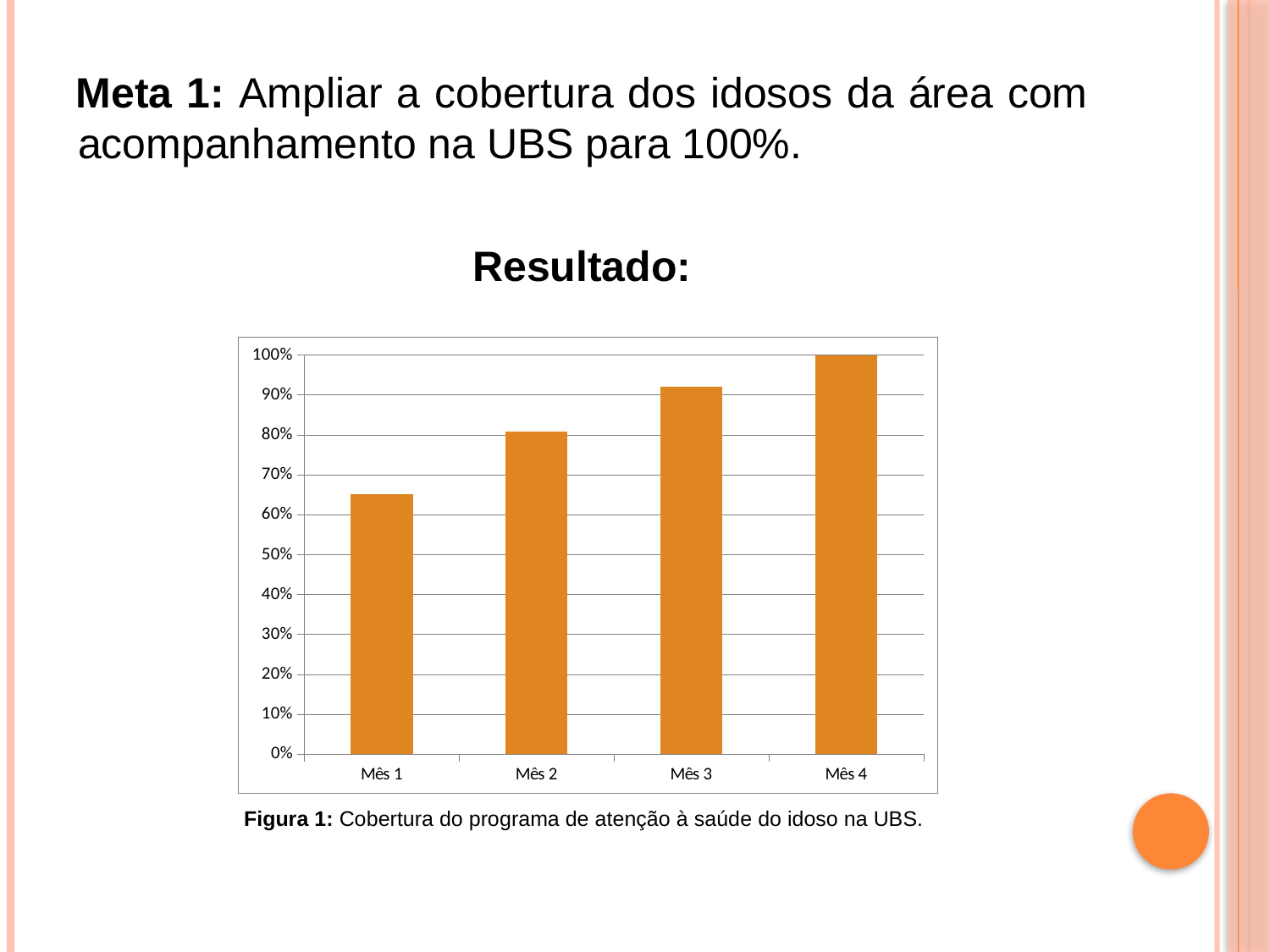
Which is larger, the value for Mês 3 or the value for Mês 1? Mês 3 Do the values rise or fall from Mês 1 to Mês 4? rise Is the value for Mês 2 greater or less than 70%? greater Is the value for Mês 1 greater or less than 70%? less Is the value for Mês 1 greater or less than 60%? greater Which month has the lowest coverage value? Mês 1 What is the coverage value for Mês 4? 100% What kind of chart is shown on the slide? bar chart What is the caption given for the figure below the chart? Figura 1: Cobertura do programa de atenção à saúde do idoso na UBS. How many months (categories) are plotted on the x axis? 4 Which month has the highest coverage value? Mês 4